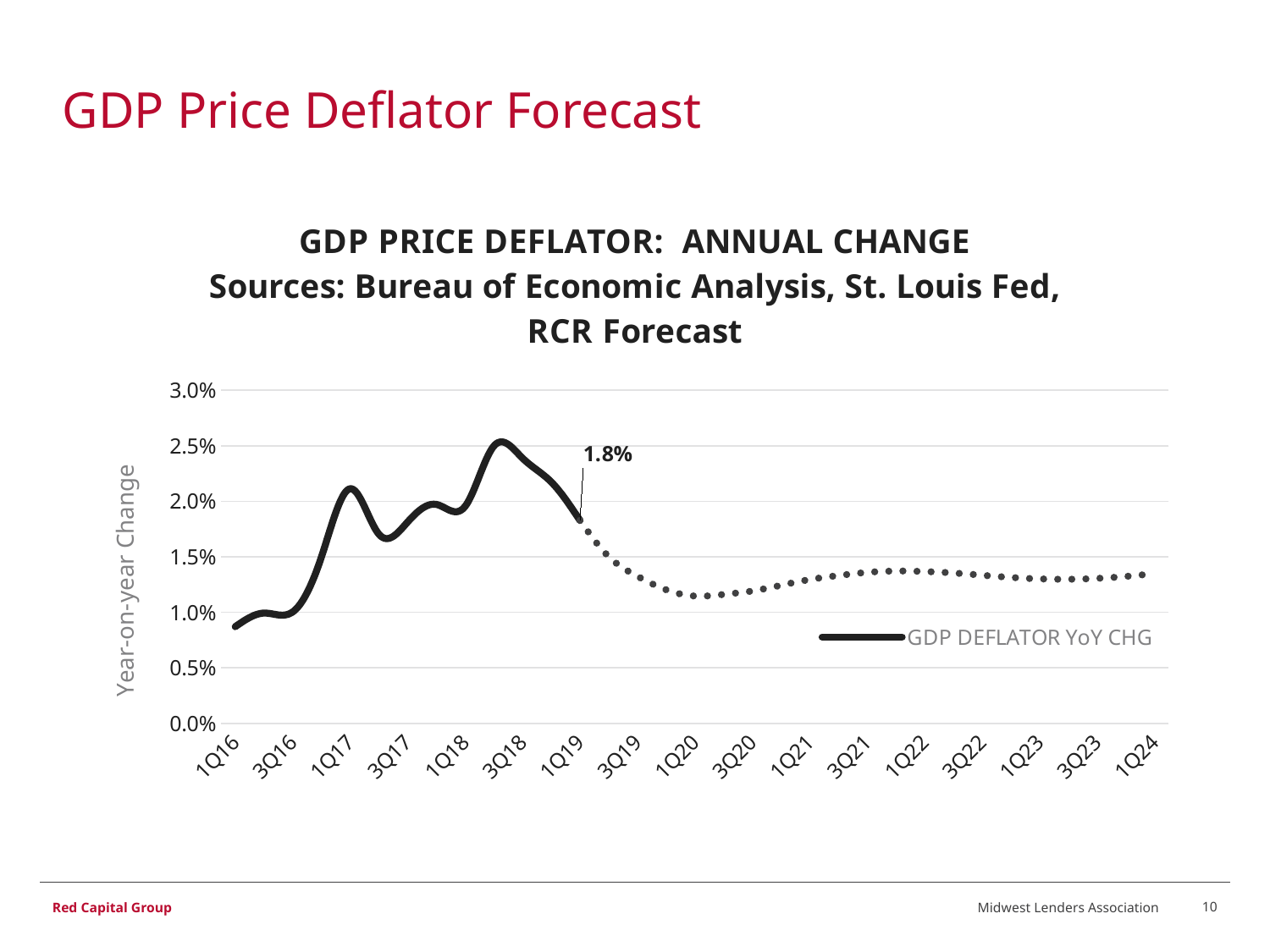
At which x-axis label is the line at its lowest value? 1Q16 Is the value for 1Q17 greater or less than 1.5%? greater What is the title of the vertical axis? Year-on-year Change What value is labelled on the line at 1Q19? 1.8% What kind of chart is shown on the slide? Line chart Which has the larger value, 1Q16 or 1Q24? 1Q24 Which has the larger value, 3Q18 or 1Q20? 3Q18 What is the legend entry for the plotted series? GDP DEFLATOR YoY CHG Between 3Q18 and 1Q20, does the line rise or fall? Fall Is the value for 1Q20 greater or less than 1.5%? less How many series does the legend list? 1 Is the value for 3Q18 greater or less than 2.0%? greater